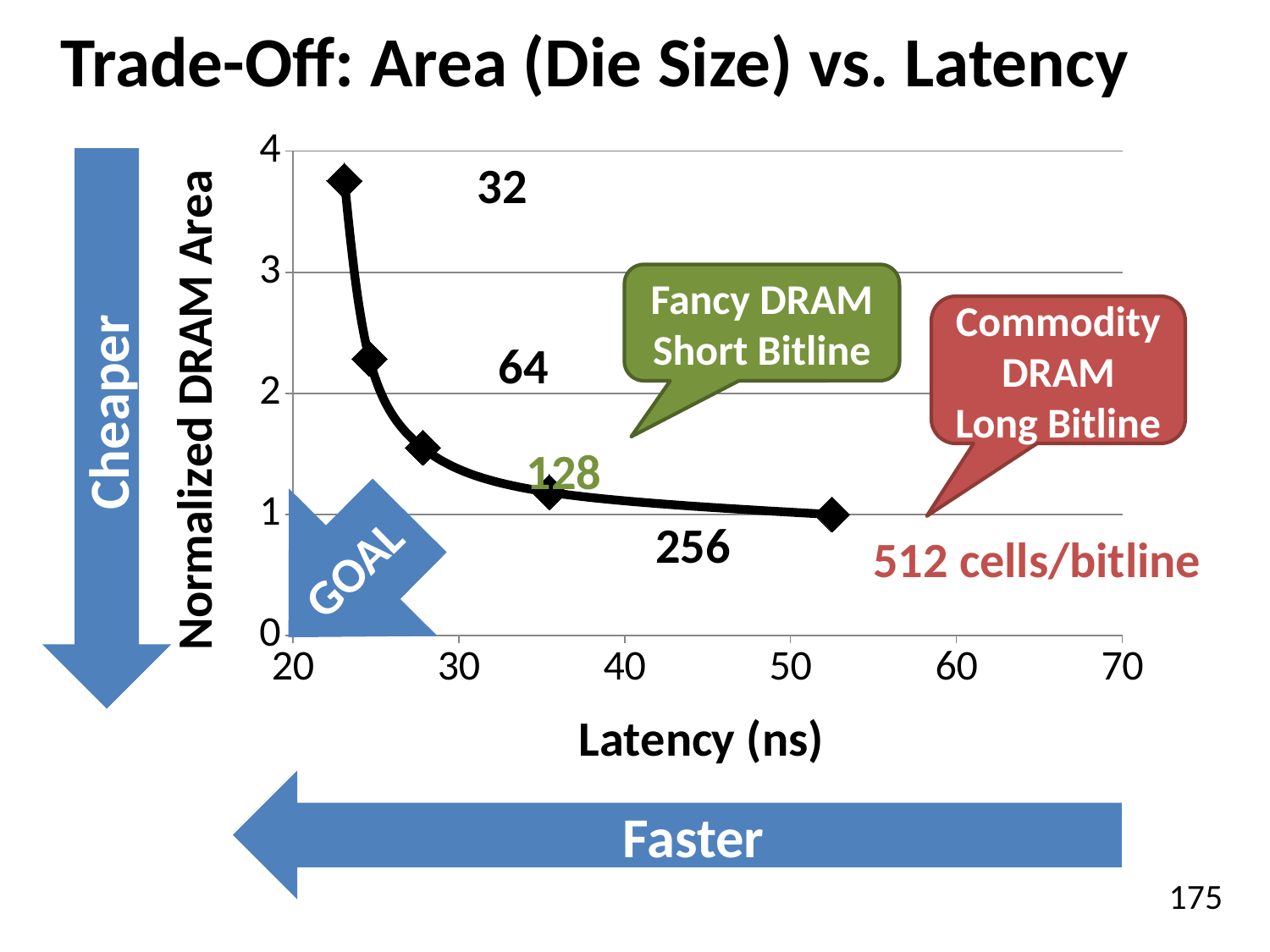
How many data points are plotted on the chart? 5 Does the normalized DRAM area rise or fall as latency increases along the x axis? fall Is the normalized DRAM area for the 64 cells/bitline point greater or less than 2? greater Which cells/bitline configuration has the lowest normalized DRAM area? 512 cells/bitline What kind of chart is shown on the slide? line chart Is the normalized DRAM area for the 256 cells/bitline point greater or less than 2? less What is the title of the slide's chart? Trade-Off: Area (Die Size) vs. Latency What is the label of the x axis? Latency (ns) Is the latency for the 512 cells/bitline point greater or less than 50 ns? greater Which cells/bitline configuration has the highest normalized DRAM area? 32 Which has a larger normalized DRAM area, the 64 cells/bitline point or the 128 cells/bitline point? 64